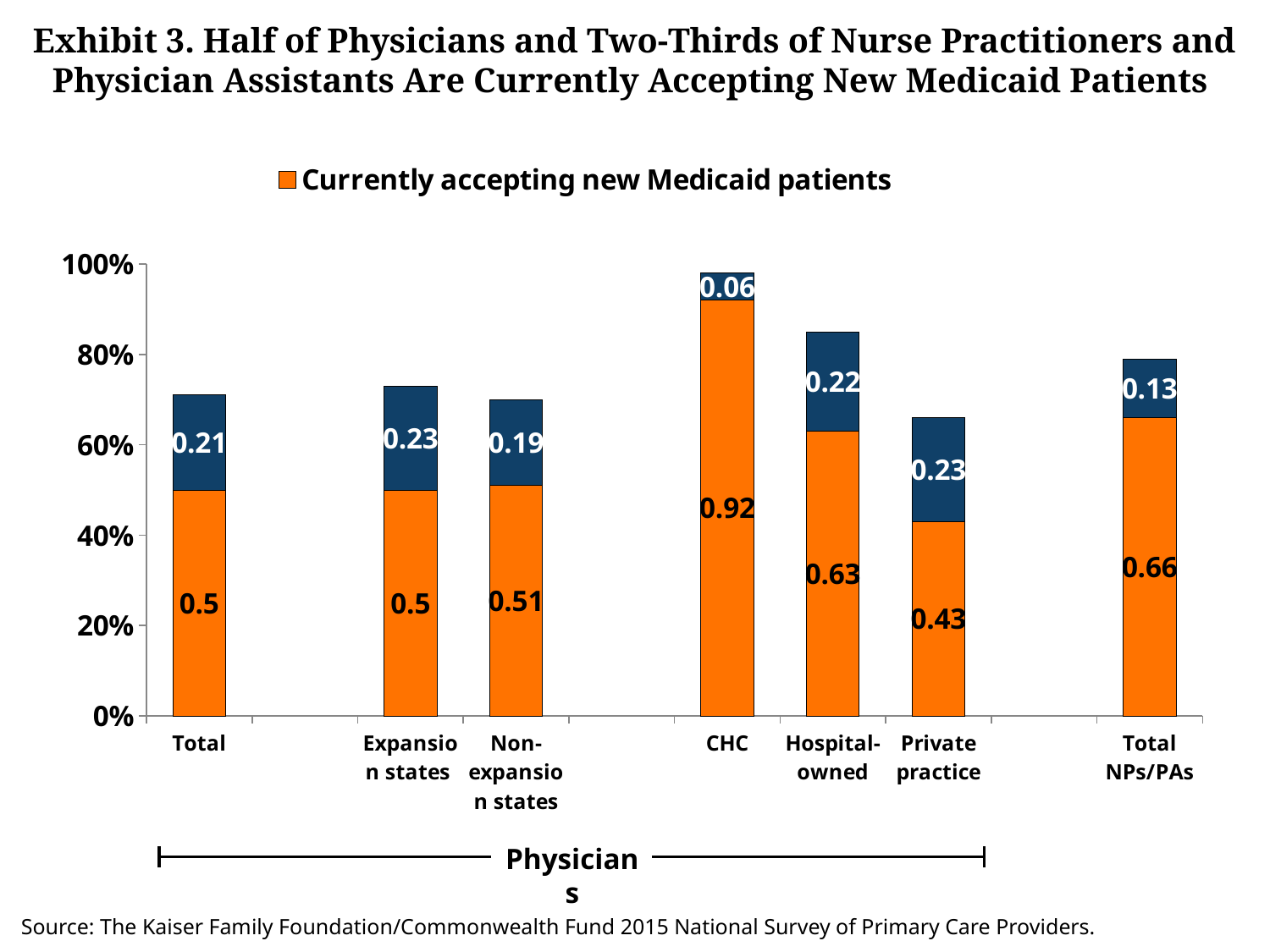
What is the value of the orange segment for Private practice? 0.43 What is the total of the stacked bar for Total NPs/PAs? 0.79 How many series does the legend list? 1 What kind of chart is shown on the slide? Stacked bar chart Which category has the lowest orange 'Currently accepting new Medicaid patients' value? Private practice What is the value of the orange 'Currently accepting new Medicaid patients' segment for CHC? 0.92 How many categories are shown on the x axis? 7 What is the difference between the orange segment values for CHC and Hospital-owned? 0.29 What is the value of the dark blue segment for Total NPs/PAs? 0.13 What is the total of the stacked bar for Hospital-owned? 0.85 Which category has the highest orange 'Currently accepting new Medicaid patients' value? CHC Which has a larger orange segment value, Total NPs/PAs or Total? Total NPs/PAs